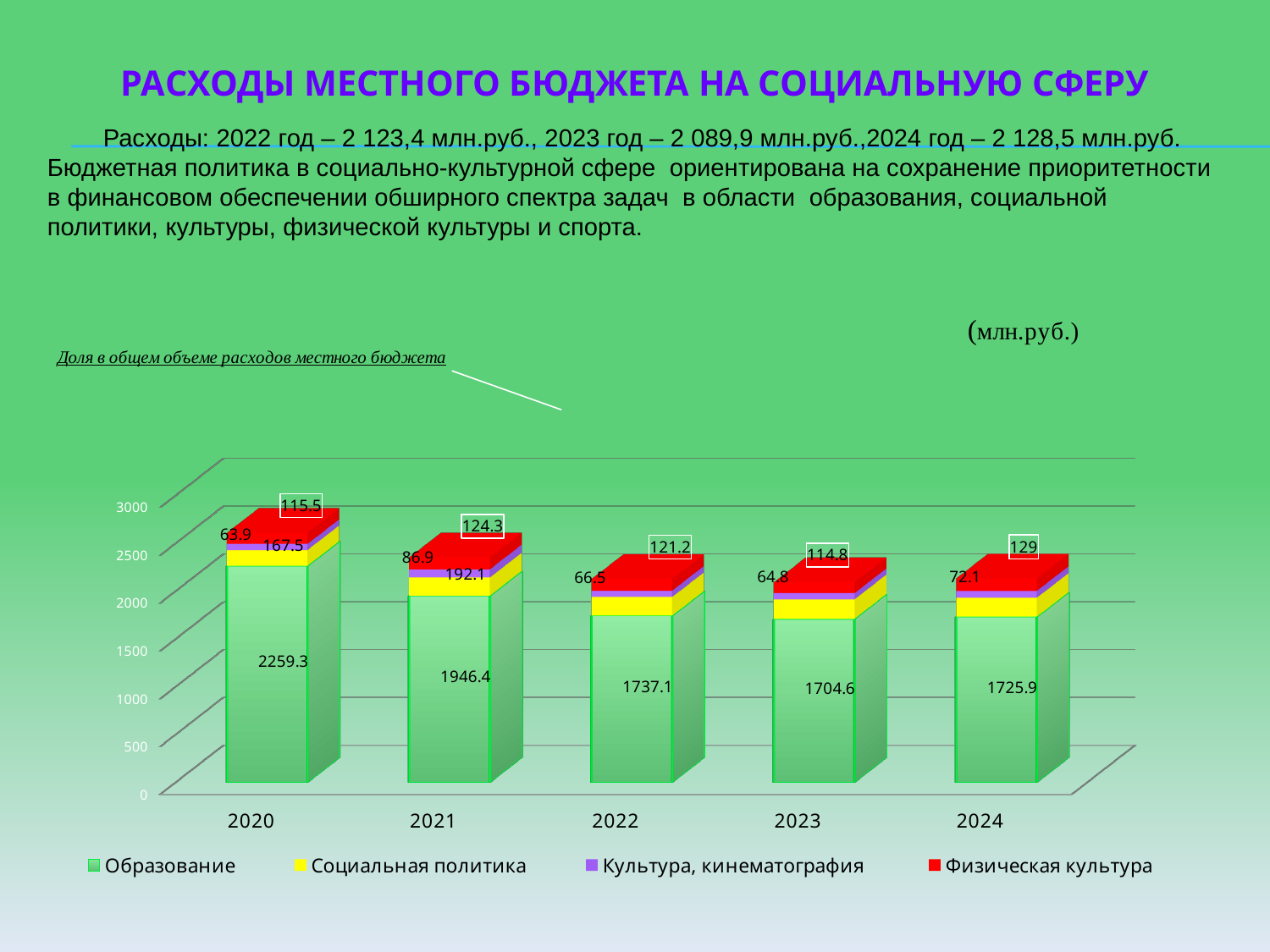
What kind of chart is shown on the slide? bar chart In which year is the value for Образование lowest? 2023 In which year is the value for Образование highest? 2020 Which year has the larger Образование value, 2022 or 2024? 2022 What is the value for Физическая культура in 2024? 129 How many years are shown on the x axis of the chart? 5 Is the value for Образование in 2021 greater or less than 1500? greater What is the value for Образование in 2023? 1704.6 What is the difference between the Образование values for 2020 and 2021? 312.9 What is the value for Образование in 2020? 2259.3 Does the value for Образование rise or fall from 2020 to 2022? fall How many series does the legend list? 4